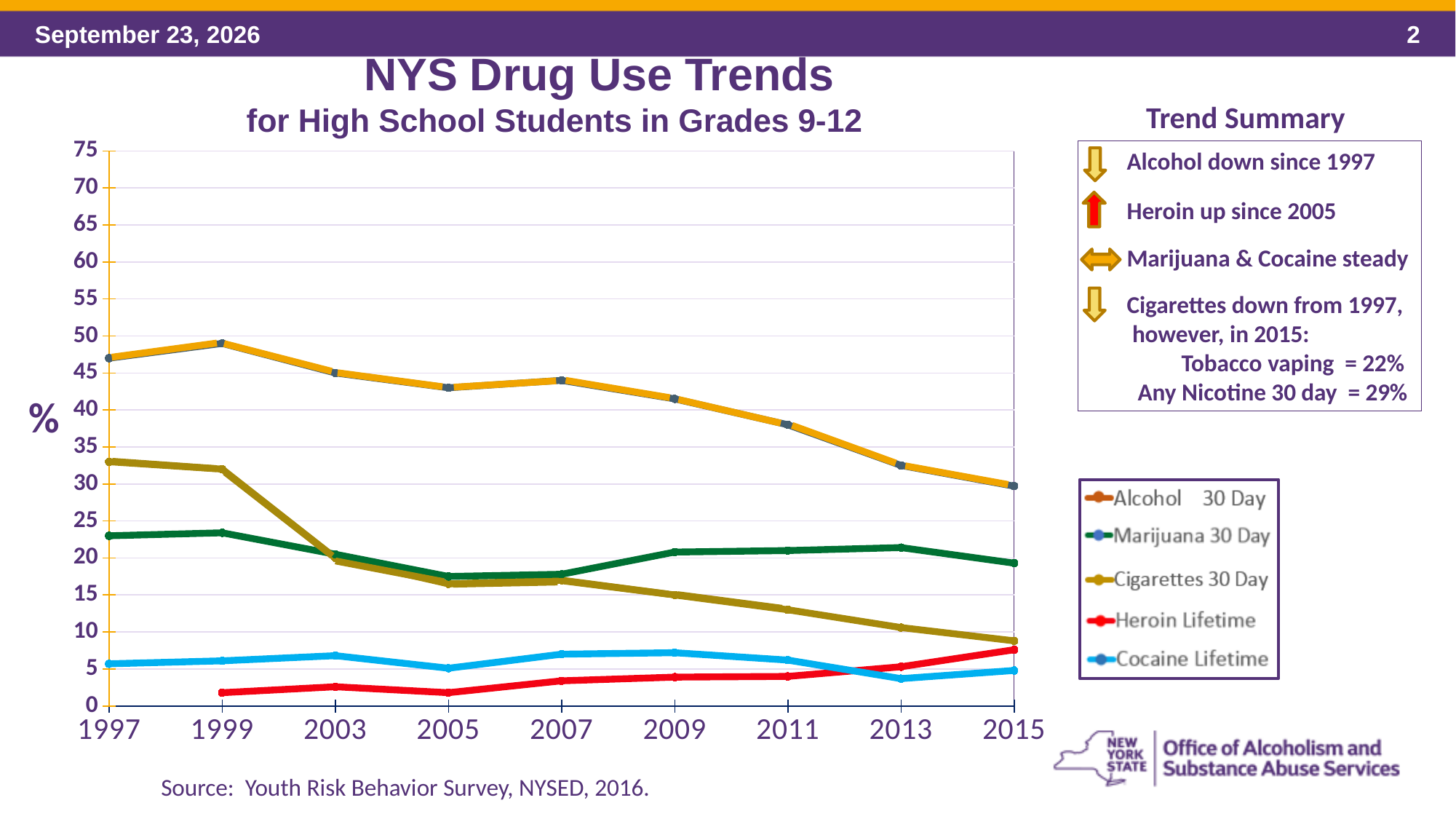
How many series does the legend list? 5 Does the Alcohol 30 Day line rise or fall from 1997 to 2015? fall What kind of chart is shown on the slide? line chart Which series has the highest value in 2015? Alcohol 30 Day Is the value for Marijuana 30 Day in 2005 greater or less than 20? less Is the value for Cigarettes 30 Day in 1997 greater or less than 30? greater Is the value for Alcohol 30 Day in 2015 greater or less than 35? less Which series has the lowest value in 1999? Heroin Lifetime In 2015, which is larger: Heroin Lifetime or Cocaine Lifetime? Heroin Lifetime How many years are shown along the x axis? 9